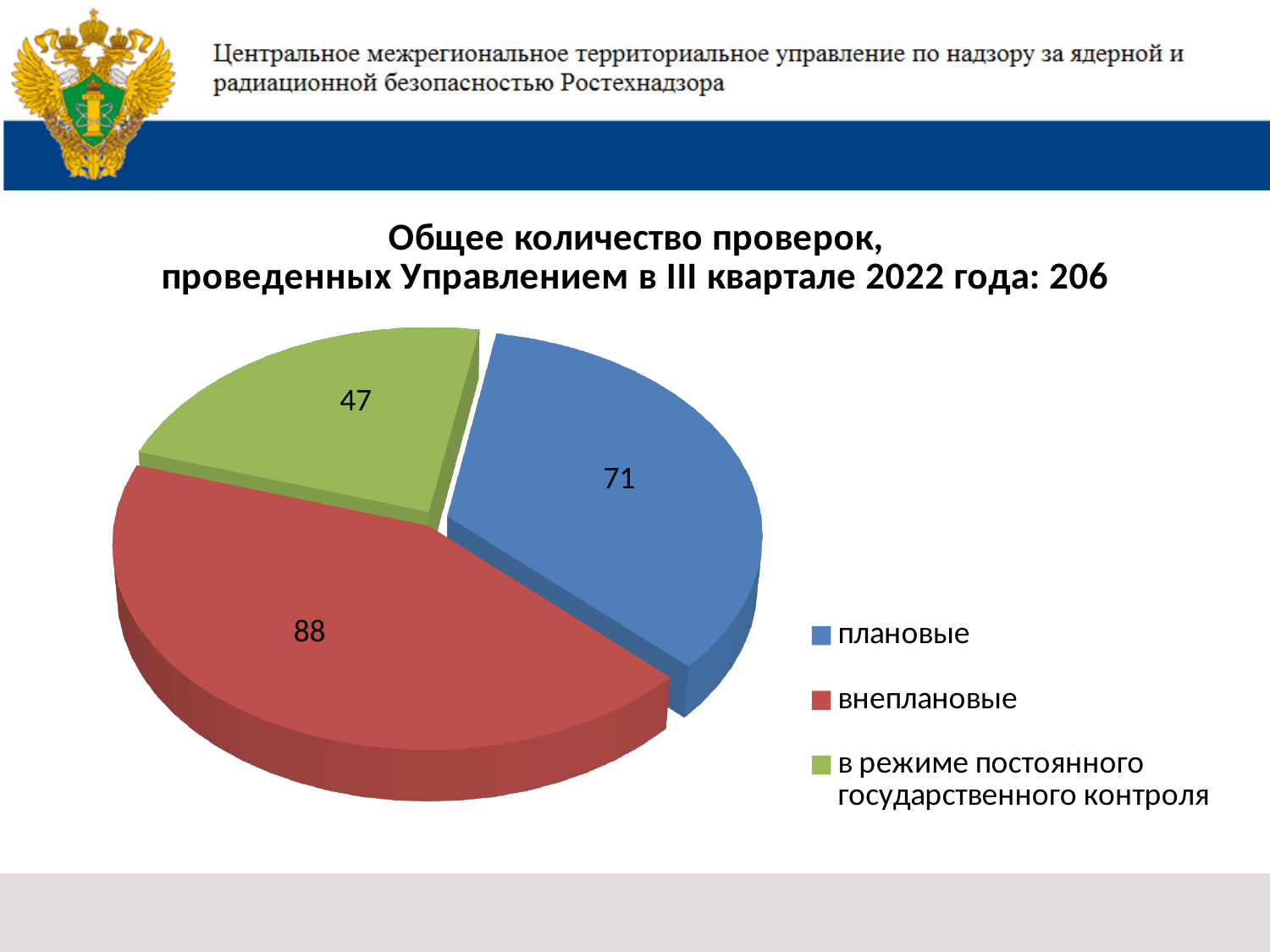
How many entries does the legend list? 3 Which category has the smallest slice? в режиме постоянного государственного контроля Which category has the largest slice? внеплановые What is the total of all slices in the pie chart? 206 How many slices does the pie chart have? 3 Which is larger, the value for плановые or the value for в режиме постоянного государственного контроля? плановые What is the difference between the values for внеплановые and плановые? 17 Which colour represents внеплановые in the pie chart? red What is the value for плановые? 71 What is the value for внеплановые? 88 What type of chart is shown on the slide? pie chart What is the value for в режиме постоянного государственного контроля? 47